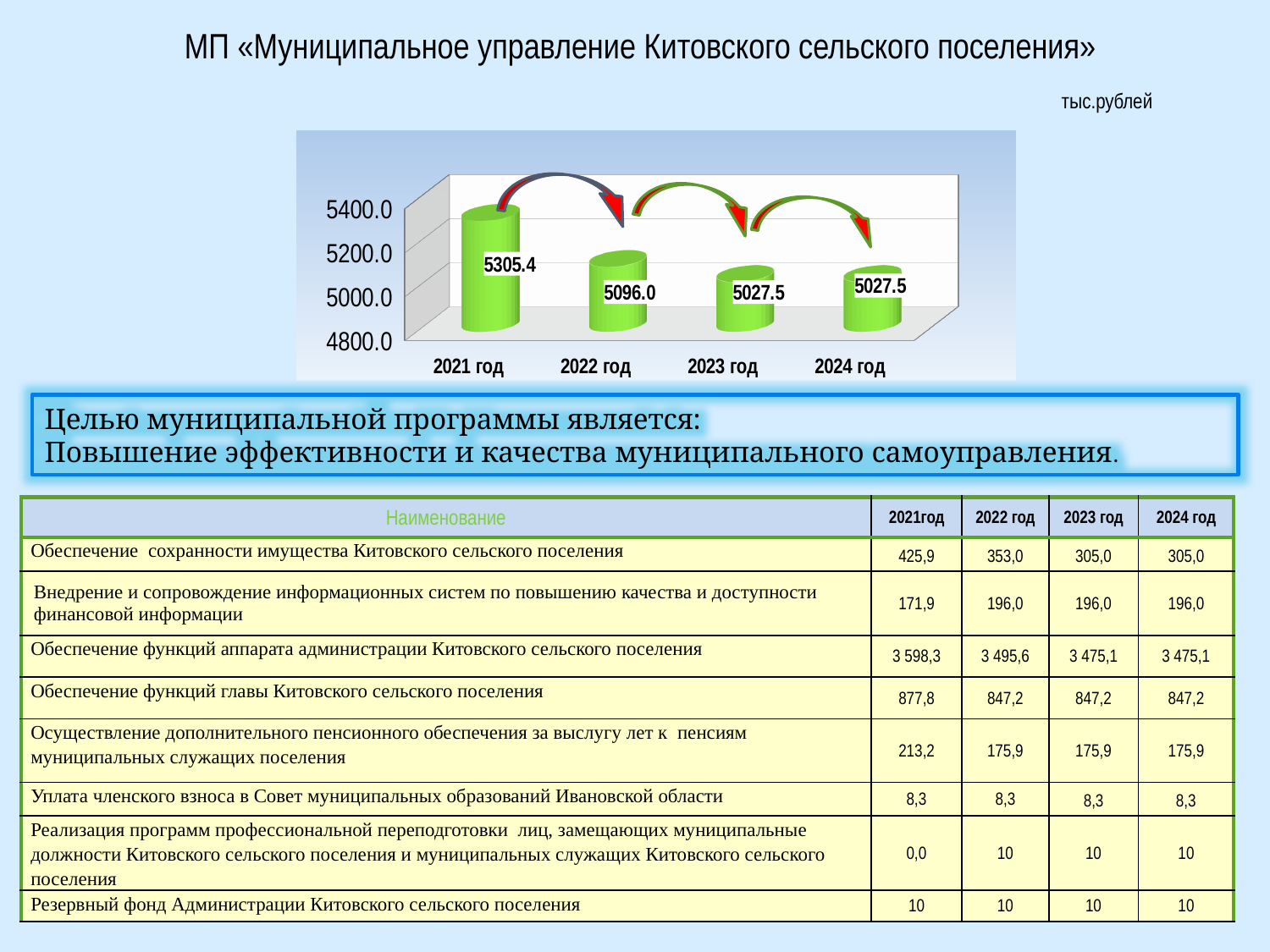
What is the value shown for 2024 год? 5027.5 Is the value for 2021 год greater or less than 5200.0? greater Which is larger, the value for 2021 год or the value for 2023 год? 2021 год Is the value for 2023 год greater or less than 5200.0? less What is the difference between the values for 2022 год and 2023 год? 68.5 What kind of chart is shown on the slide? bar chart Which year has the highest value in the chart? 2021 год What is the difference between the values for 2021 год and 2022 год? 209.4 What is the value shown for 2021 год? 5305.4 How many years are shown on the x axis of the chart? 4 What is the value shown for 2022 год? 5096.0 Do the values rise or fall from 2021 год to 2023 год? fall